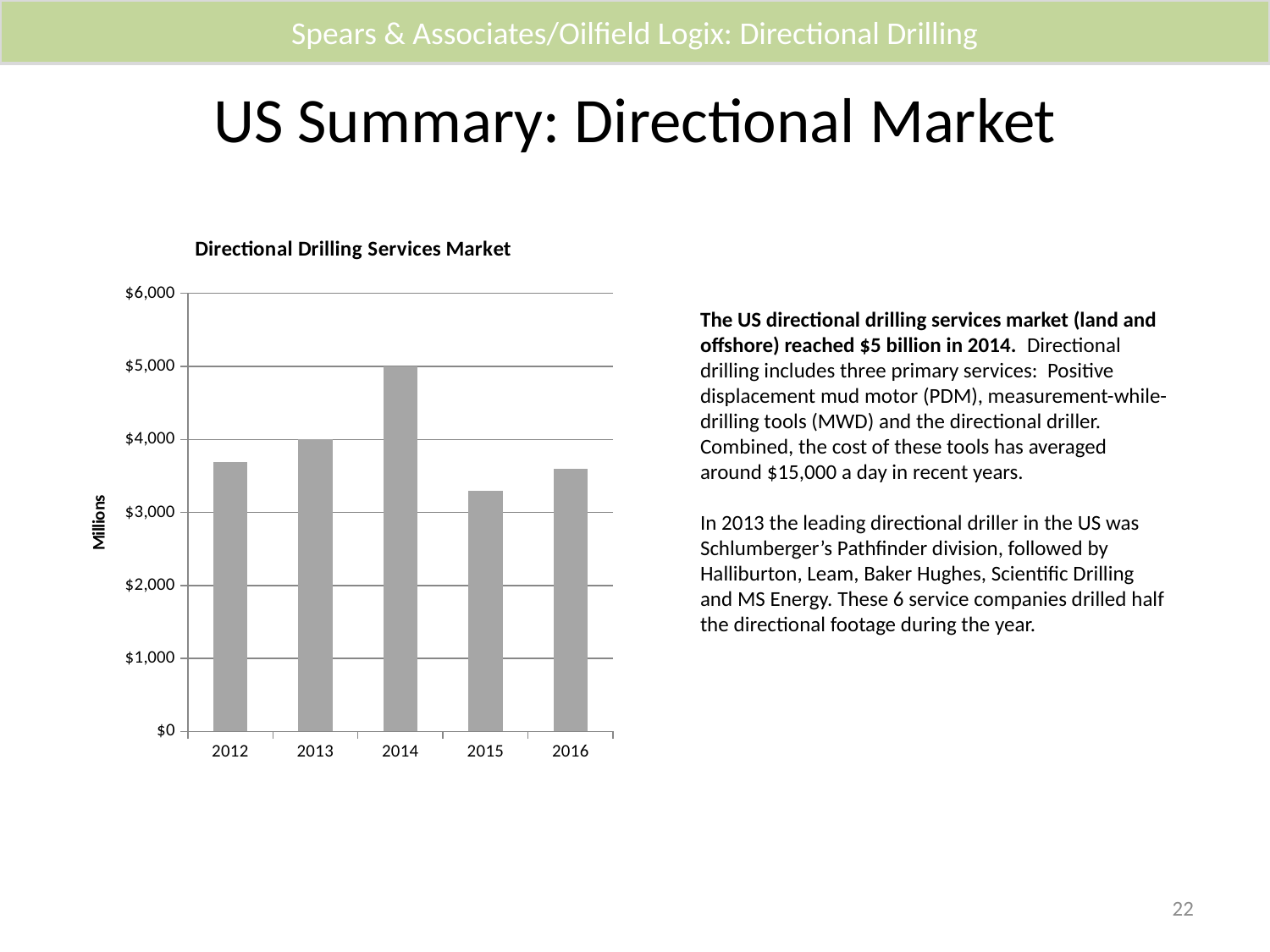
What kind of chart is shown on the slide? bar chart Is the value for 2012 greater or less than $3,000? greater Does the value rise or fall from 2014 to 2015? fall Which is larger, the value for 2013 or the value for 2015? 2013 How many years are plotted on the chart? 5 What is the title of the chart? Directional Drilling Services Market Which year has the lowest value on the chart? 2015 Is the value for 2016 greater or less than $4,000? less Is the value for 2015 greater or less than $4,000? less Which year has the highest value on the chart? 2014 What is the value for 2014 on the chart? $5,000 What is the label on the vertical axis of the chart? Millions